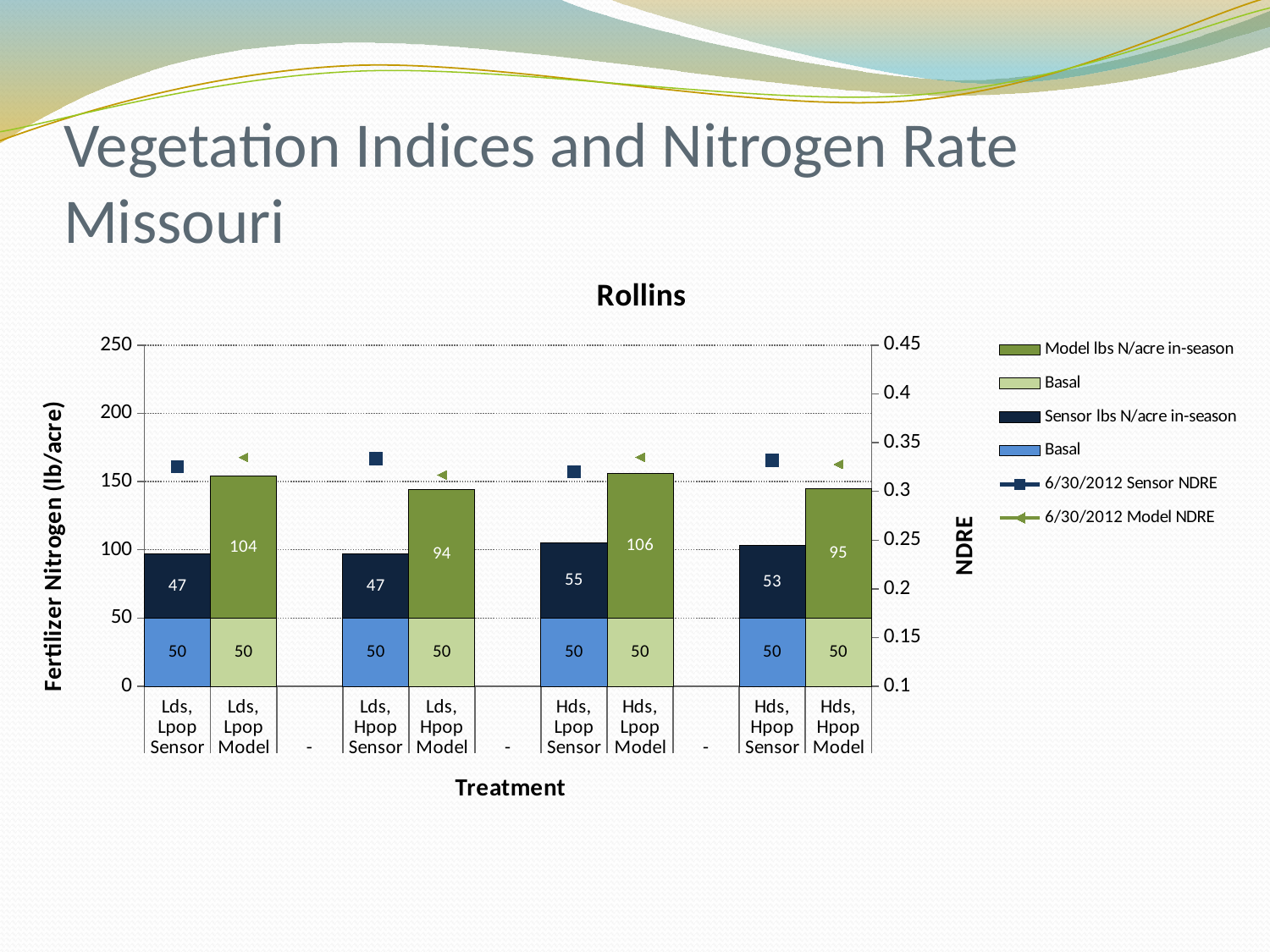
What is the Basal value for the Lds, Hpop Model treatment? 50 What is the Model lbs N/acre in-season value for the Hds, Lpop Model treatment? 106 Which treatment has the highest Model lbs N/acre in-season value? Hds, Lpop Model What kind of chart is shown under the title "Rollins"? combination bar and line chart Which treatment has the lowest Model lbs N/acre in-season value? Lds, Hpop Model What is the difference between the Model in-season values for Hds, Lpop Model and Lds, Hpop Model? 12 What is the total fertilizer nitrogen for the Lds, Lpop Model bar (Basal plus Model in-season)? 154 Which treatment has the highest Sensor lbs N/acre in-season value? Hds, Lpop Sensor Is the 6/30/2012 Sensor NDRE value for the Lds, Lpop Sensor treatment greater or less than 0.3? greater What is the Sensor lbs N/acre in-season value for the Hds, Hpop Sensor treatment? 53 How many entries does the legend list? 6 Which is larger: the Sensor in-season value for Hds, Lpop Sensor or for Lds, Lpop Sensor? Hds, Lpop Sensor